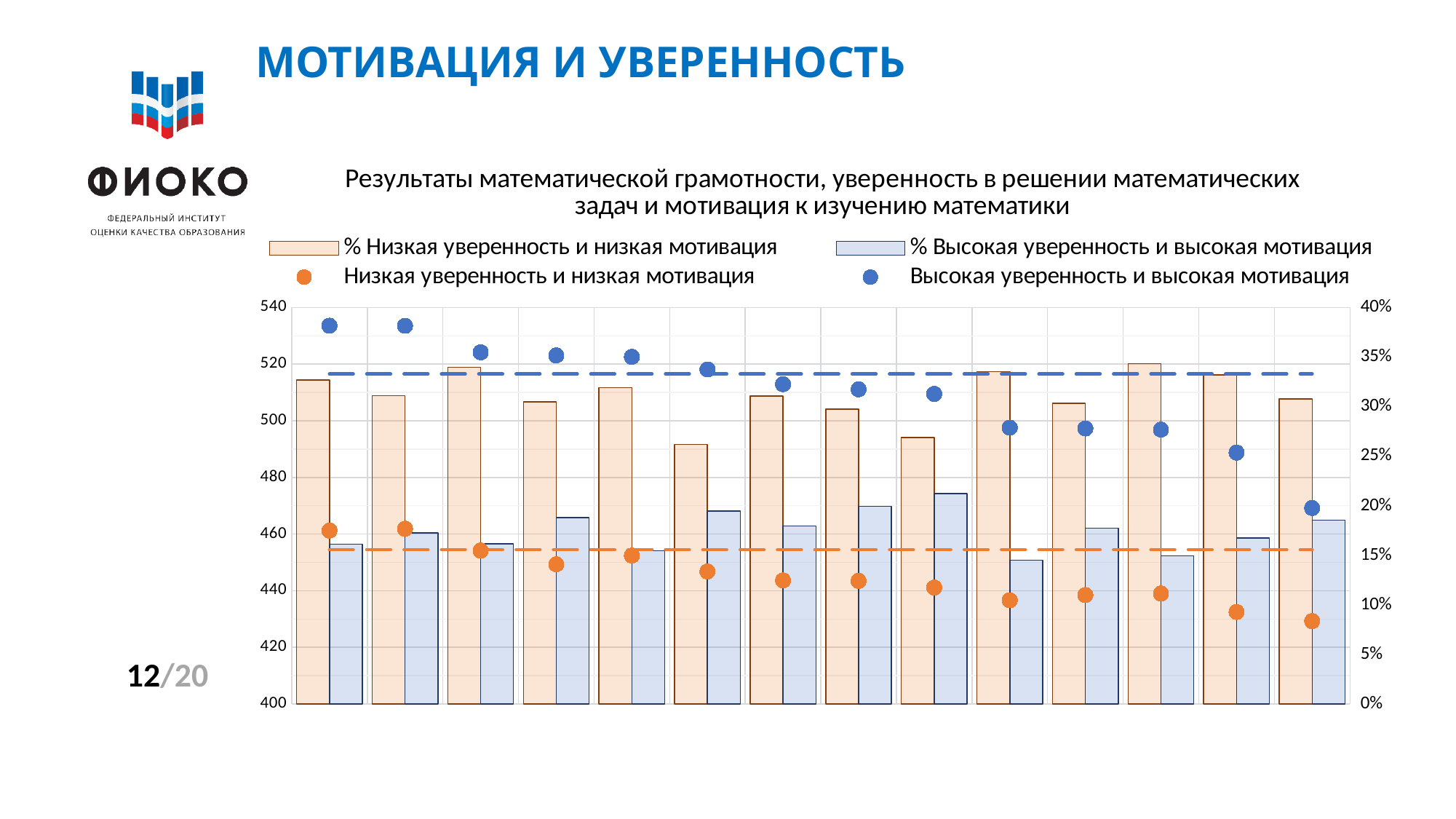
What is the maximum value shown on the right-hand percentage axis? 40% How many groups of bars are plotted along the x axis? 14 What is the title of the chart? Результаты математической грамотности, уверенность в решении математических задач и мотивация к изучению математики In the leftmost group, which bar is taller: the orange bar (% Низкая уверенность и низкая мотивация) or the blue bar (% Высокая уверенность и высокая мотивация)? The orange bar Do the blue dots (Высокая уверенность и высокая мотивация) generally rise or fall from left to right along the x axis? fall What is the minimum value shown on the left-hand axis? 400 Which legend entry is shown with blue dot markers? Высокая уверенность и высокая мотивация Do the orange dots (Низкая уверенность и низкая мотивация) generally rise or fall from left to right along the x axis? fall What kind of chart is shown on the slide? A bar chart combined with dot markers (combo chart) How many series does the chart legend list? 4